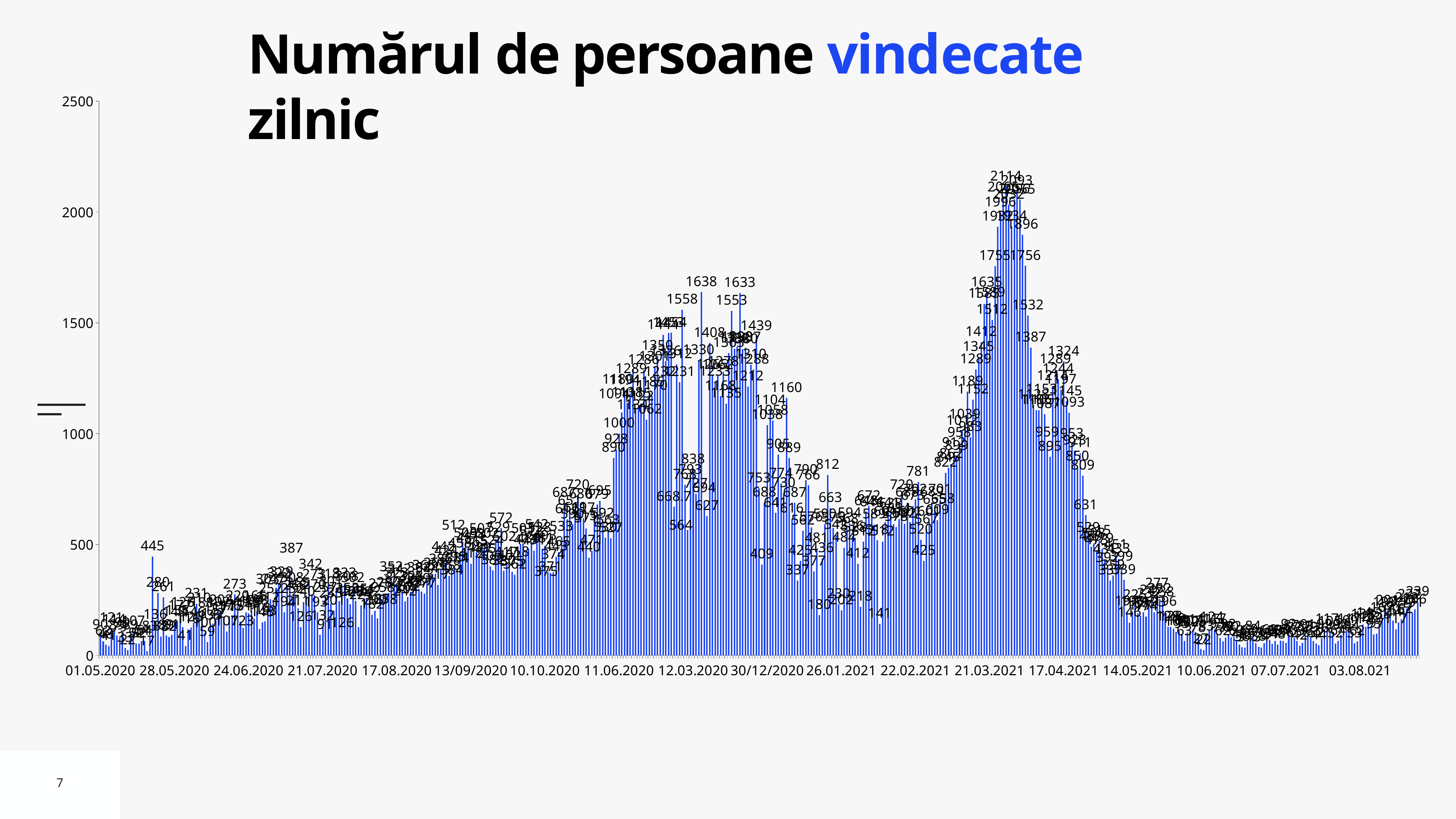
What is the difference between the bars labelled 1755 and 1756 near the 2021 peak? 1 What is the title of the chart on the slide? Numărul de persoane vindecate zilnic What is the highest value labelled on the chart? 2114 Which peak is higher: the one around 21.03.2021 or the one around 12.03.2020? the one around 21.03.2021 What is the highest value shown on the vertical axis? 2500 What kind of chart is shown on the slide? bar chart Is the value for the first bar at 01.05.2020 greater or less than 500? less What is the difference between the highest labelled value (2114) and the highest labelled value of the earlier peak (1638)? 476 Is the tallest bar near 21.03.2021 greater or less than 2000? greater Do the values rise or fall between 07.07.2021 and 03.08.2021? rise Do the values rise or fall between 14.05.2021 and 10.06.2021? fall Is the value for the bar at 03.08.2021 greater or less than 500? less